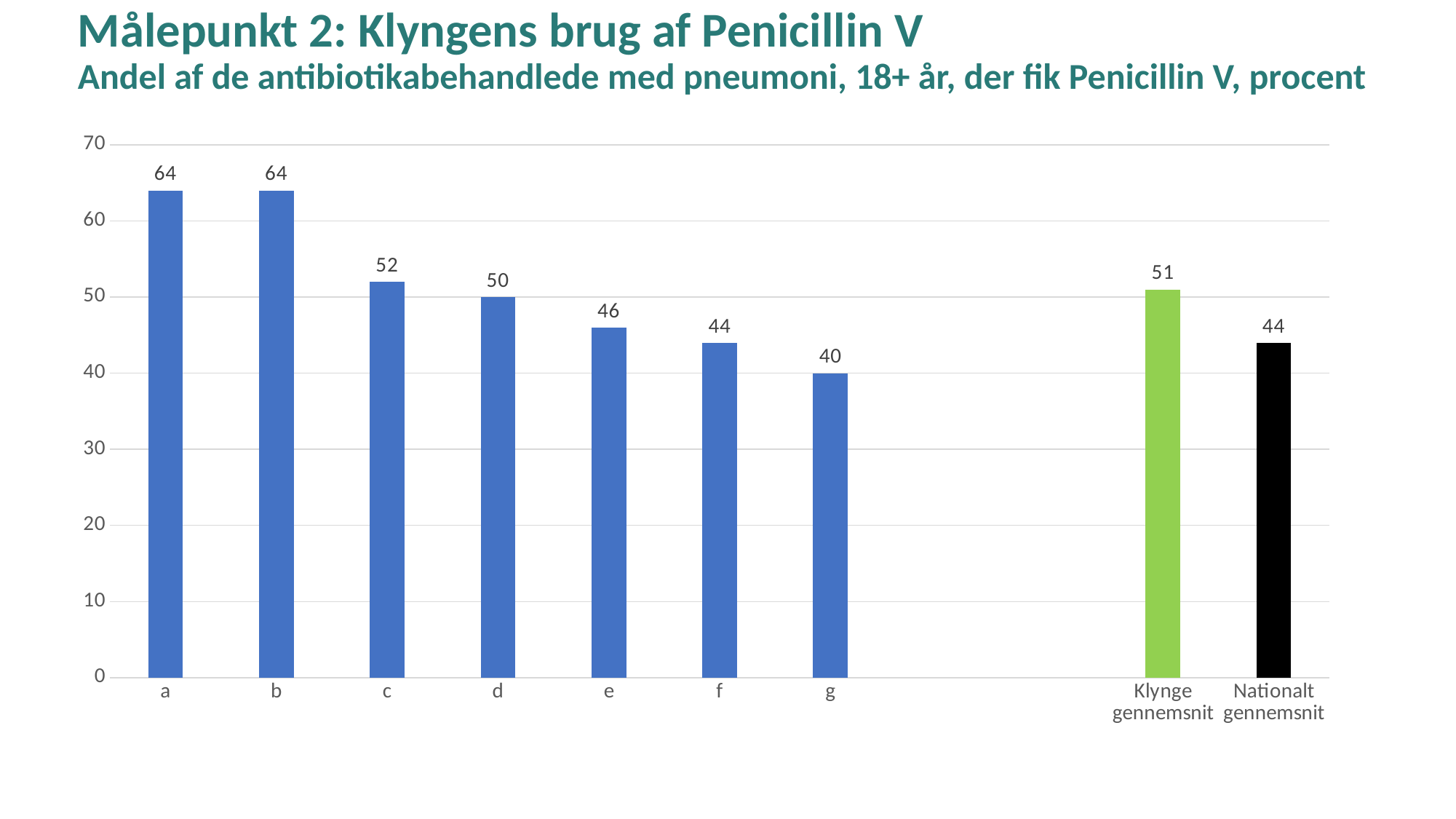
What is the difference between Klynge gennemsnit and Nationalt gennemsnit? 7 What is the value for category c? 52 What kind of chart is shown on the slide? bar chart How many bars are plotted on the chart? 9 Is the value for e greater or less than 50? less Do the values rise or fall from category a to category g? fall Which is larger, the value for d or the value for e? d What is the value for Klynge gennemsnit? 51 What is the difference between the values for a and g? 24 Which of the lettered categories (a to g) has the lowest value? g What is the value for Nationalt gennemsnit? 44 What colour is the bar for Nationalt gennemsnit? black